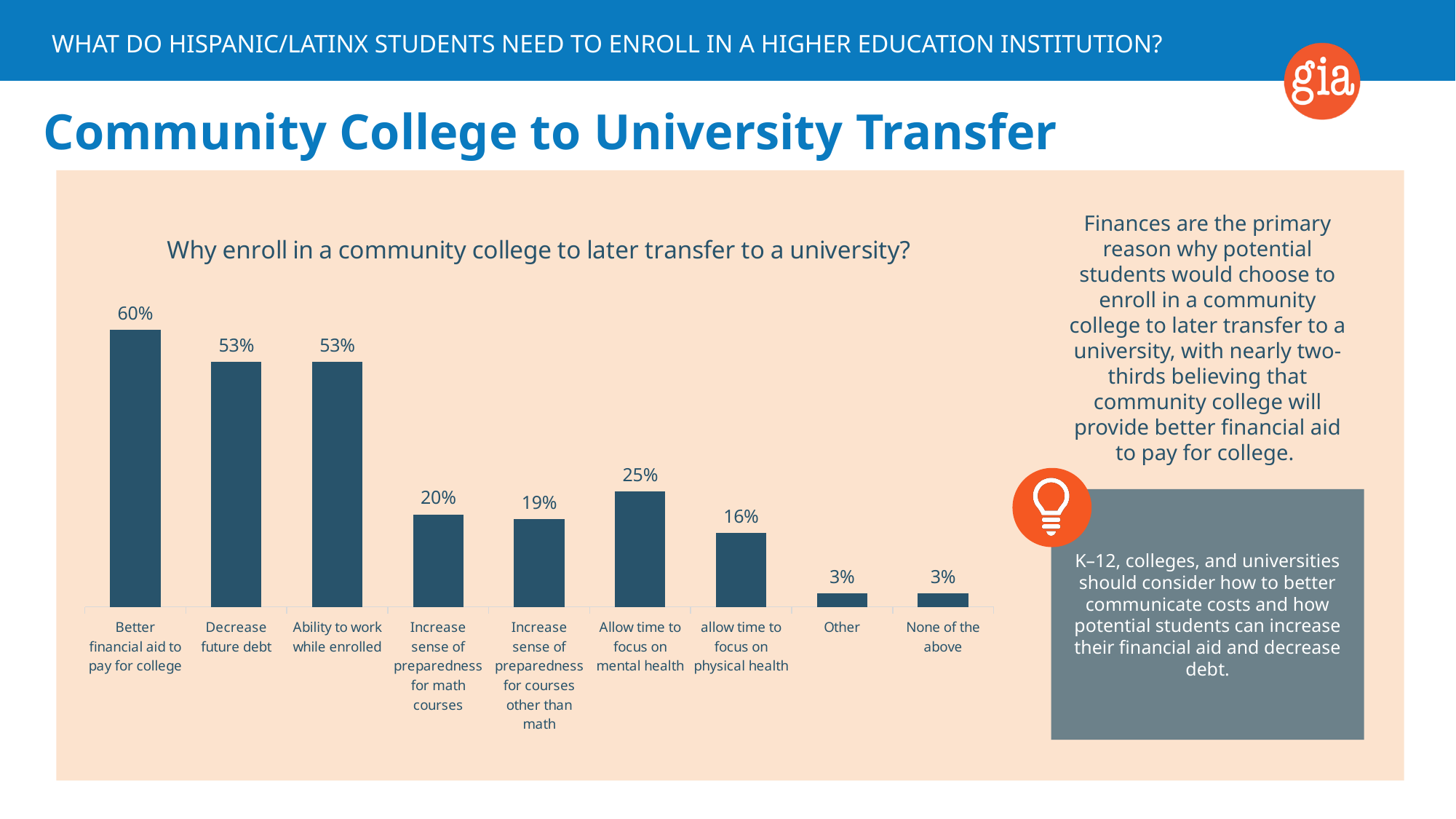
What is the value shown for "Allow time to focus on mental health"? 25% What is the difference between the values for "Better financial aid to pay for college" and "Decrease future debt"? 7% Which category has the highest value in the chart? Better financial aid to pay for college What is the value shown for "Other"? 3% Which two categories share the value 53%? Decrease future debt and Ability to work while enrolled What type of chart is shown on the slide? Bar chart What percentage of respondents chose "Better financial aid to pay for college" as a reason to enroll in a community college to later transfer to a university? 60% What percentage is shown for "Increase sense of preparedness for courses other than math"? 19% What is the difference between the values for "Increase sense of preparedness for math courses" and "allow time to focus on physical health"? 4% Which is larger: the value for "Allow time to focus on mental health" or the value for "allow time to focus on physical health"? Allow time to focus on mental health What is the title of the chart? Why enroll in a community college to later transfer to a university? How many categories are shown in the chart? 9